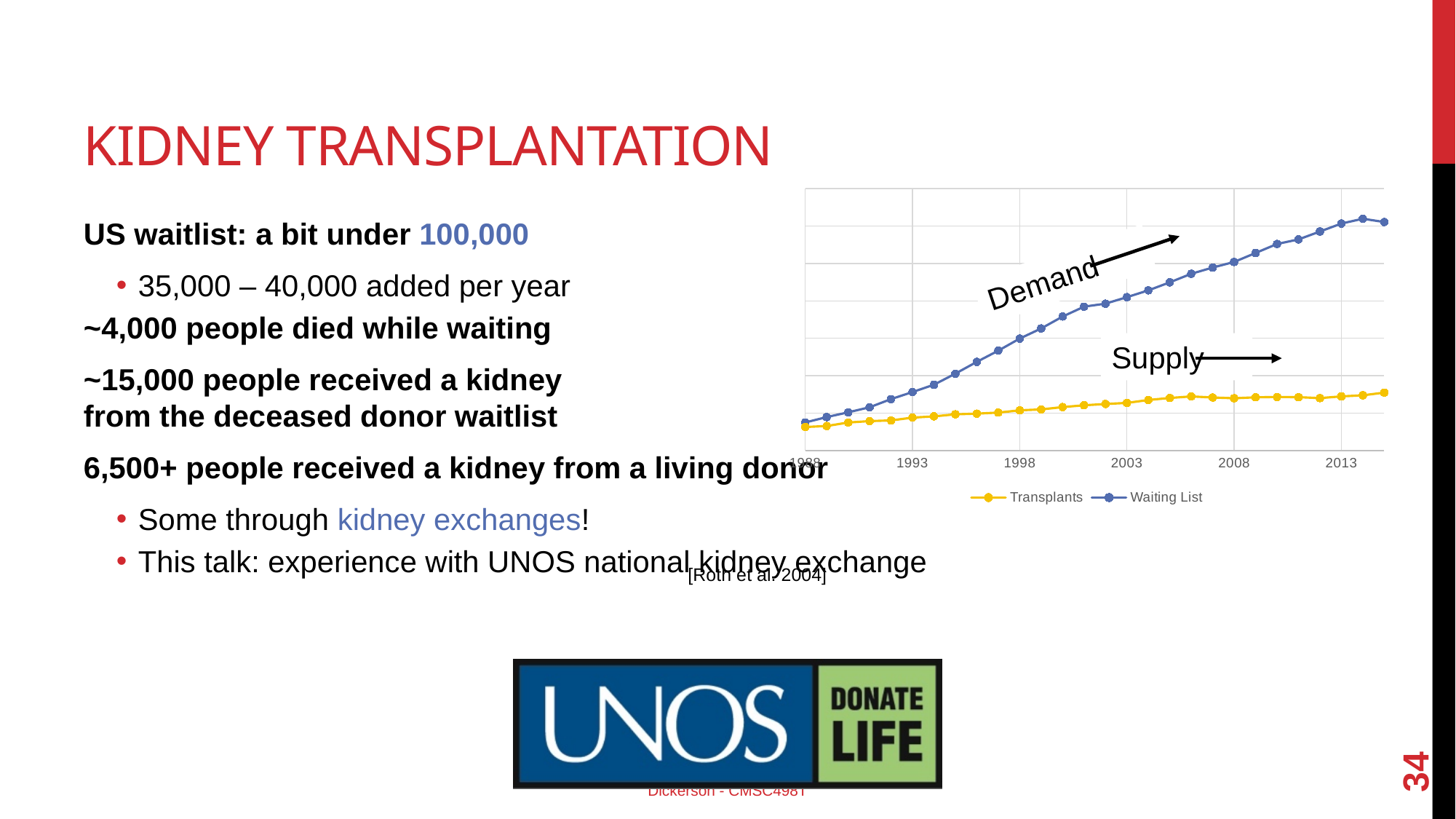
What are the two series named in the chart legend? Transplants and Waiting List What is the last year label on the x axis of the chart? 2013 Which series is annotated with the word 'Supply' on the chart? Transplants Which series is annotated with the word 'Demand' on the chart? Waiting List Which series is higher in 2013, Transplants or Waiting List? Waiting List How many year labels are shown on the x axis of the chart? 6 Does the Waiting List series rise or fall from 1988 to 2013? rise What is the first year label on the x axis of the chart? 1988 What kind of chart is shown on the slide? line chart Does the Transplants series rise or fall from 1988 to 2013? rise Which series grows faster over the period shown, Transplants or Waiting List? Waiting List How many series does the chart legend list? 2